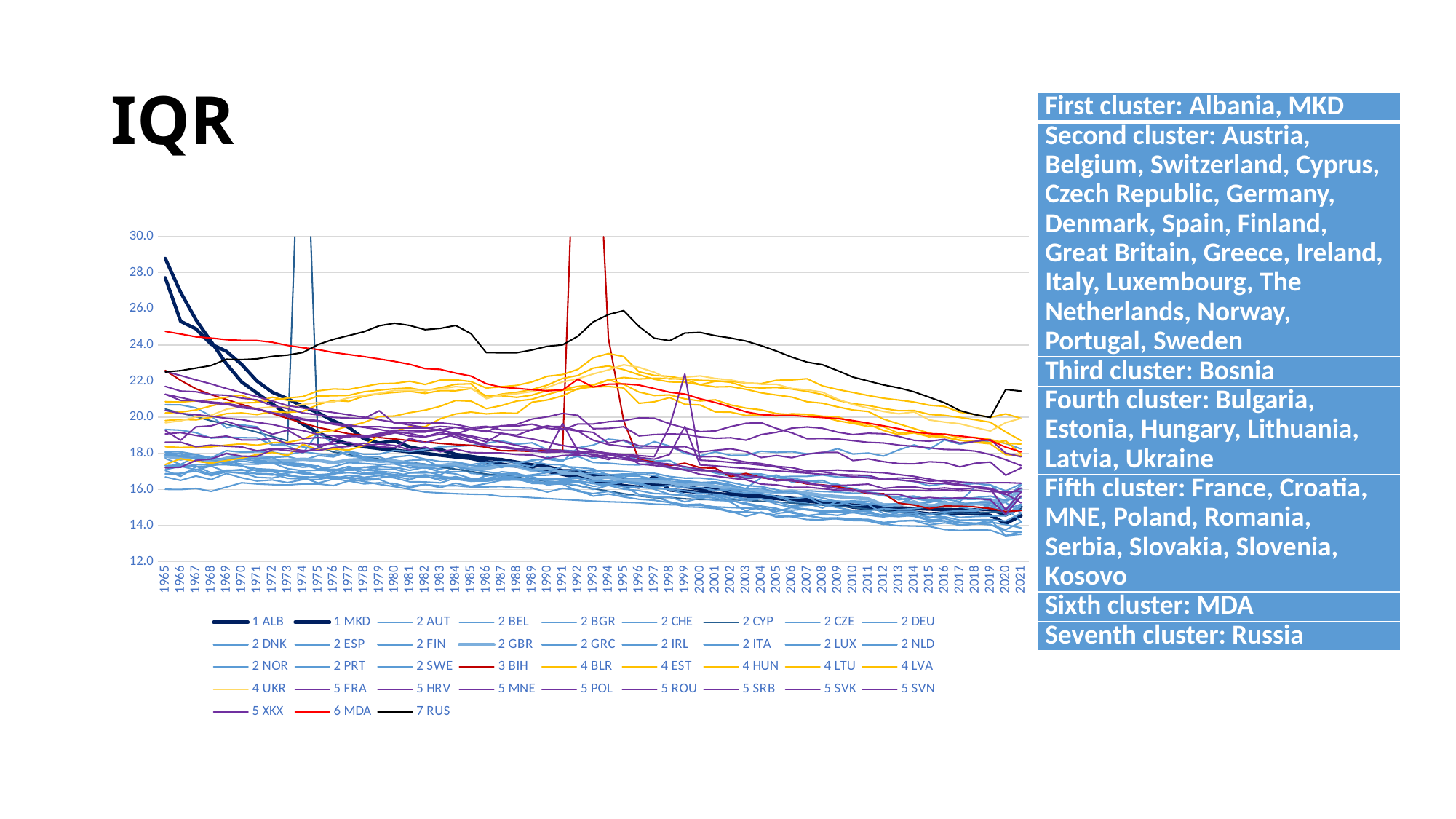
How many series does the legend list? 39 In 1965, which is larger: the value for 1 ALB or the value for 7 RUS? 1 ALB Is the value for 7 RUS in 1995 greater or less than 24.0? greater What is the first year shown on the x axis? 1965 Is the value for 7 RUS in 2021 greater or less than 20.0? greater Is the value for 1 ALB in 1965 greater or less than 28.0? greater Which series is drawn in black? 7 RUS What is the last year shown on the x axis? 2021 Which series has the highest value in 1965? 1 ALB What kind of chart is shown on the slide? line chart Does the 1 ALB line generally rise or fall from 1965 to 2021? fall What is the title of the chart? IQR